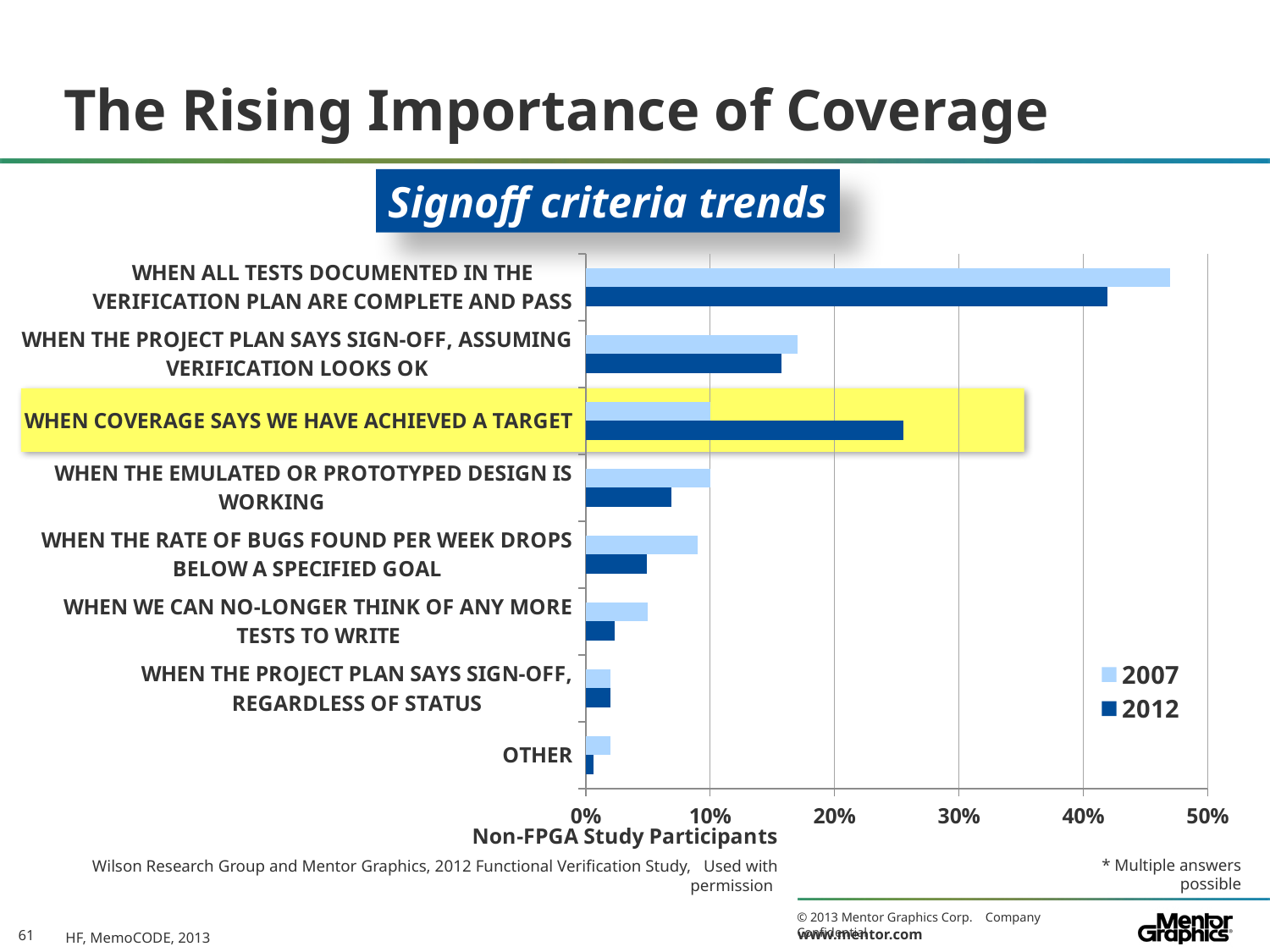
What is the title of the chart? Signoff criteria trends How many series does the legend list? 2 For 'When all tests documented in the verification plan are complete and pass', which series has the larger value, 2007 or 2012? 2007 For 'When coverage says we have achieved a target', which series has the larger value, 2007 or 2012? 2012 Is the 2012 value for 'When coverage says we have achieved a target' greater or less than 20%? greater How many signoff criteria categories are plotted on the chart? 8 Is the 2007 value for 'When all tests documented in the verification plan are complete and pass' greater or less than 40%? greater Is the 2012 value for 'When the emulated or prototyped design is working' greater or less than 10%? less What kind of chart is shown on the slide? bar chart Which category has the lowest value for 2012? Other What is the label on the horizontal axis of the chart? Non-FPGA Study Participants Which category has the highest value for 2012? When all tests documented in the verification plan are complete and pass